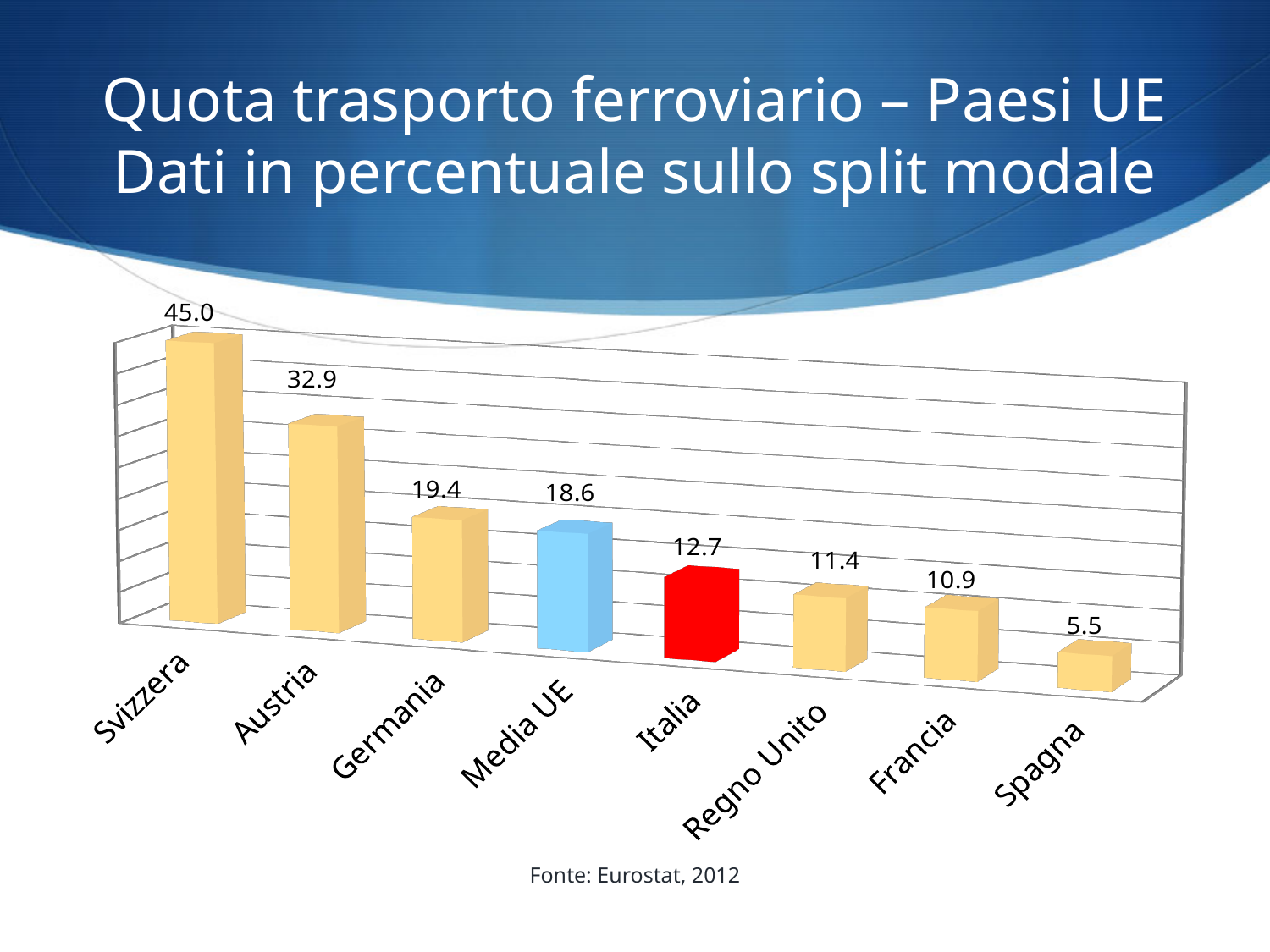
What is the difference between the values for Media UE and Italia? 5.9 How many categories are shown on the x axis? 8 What is the value for Italia? 12.7 What kind of chart is shown on the slide? Bar chart What is the value for Svizzera? 45.0 Which category has the lowest value? Spagna What is the value for Spagna? 5.5 Which category has the highest value? Svizzera Do the values rise or fall from left to right along the x axis? Fall What is the value for Media UE? 18.6 Which is larger, the value for Germania or the value for Regno Unito? Germania What is the difference between the values for Svizzera and Austria? 12.1